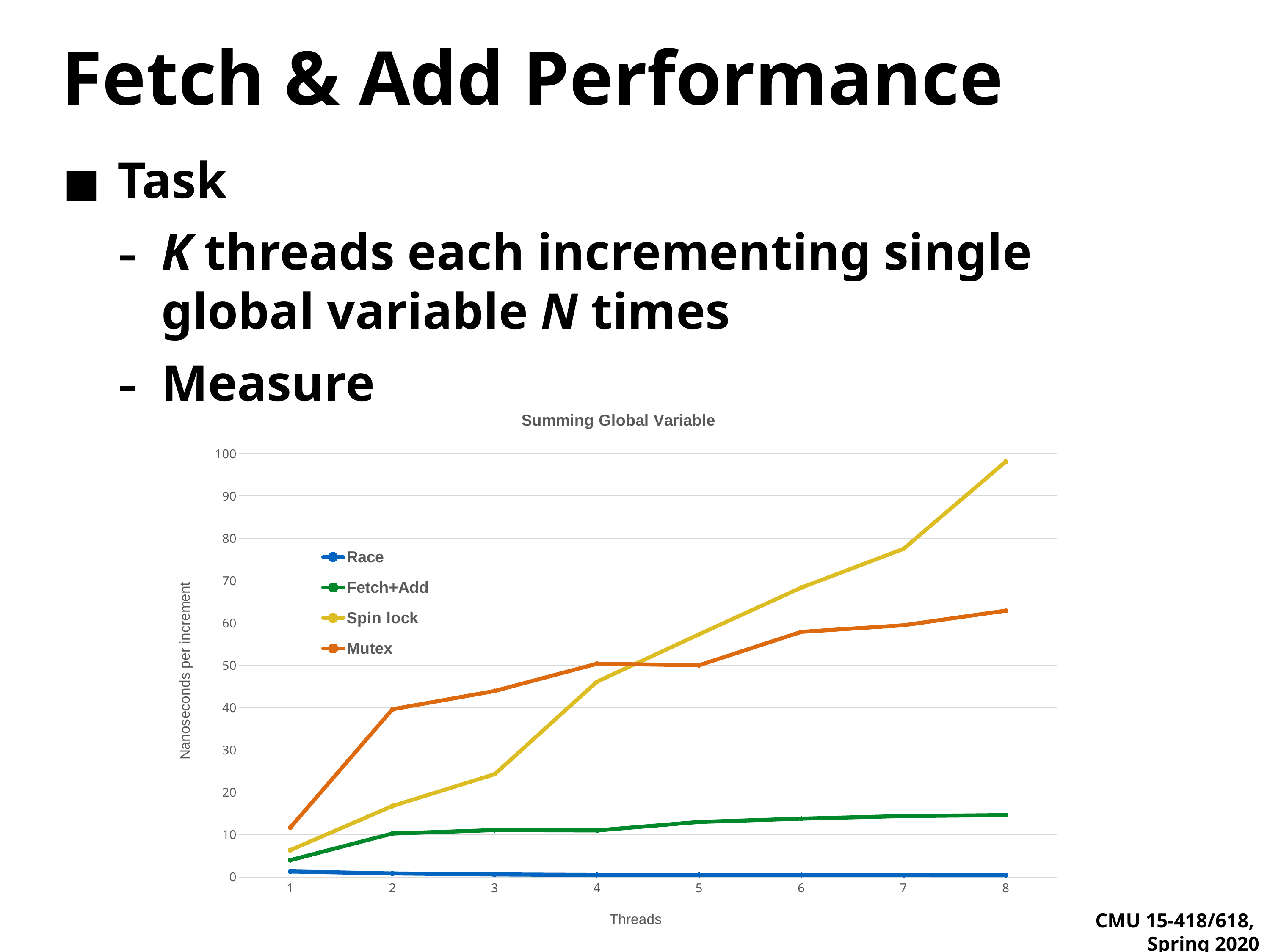
Does the Spin lock series rise or fall as the number of threads increases? rise Is the Spin lock value at 8 threads greater or less than 90? greater How many series does the chart legend list? 4 At 3 threads, which is larger: Mutex or Spin lock? Mutex What is the label of the y axis? Nanoseconds per increment Is the Mutex value at 8 threads greater or less than 70? less What kind of chart is shown on the slide? line chart What is the title of the chart? Summing Global Variable Which series has the highest value at 8 threads? Spin lock How many thread counts are plotted along the x axis? 8 Which series has the highest value at 2 threads? Mutex Which series has the lowest value at 8 threads? Race